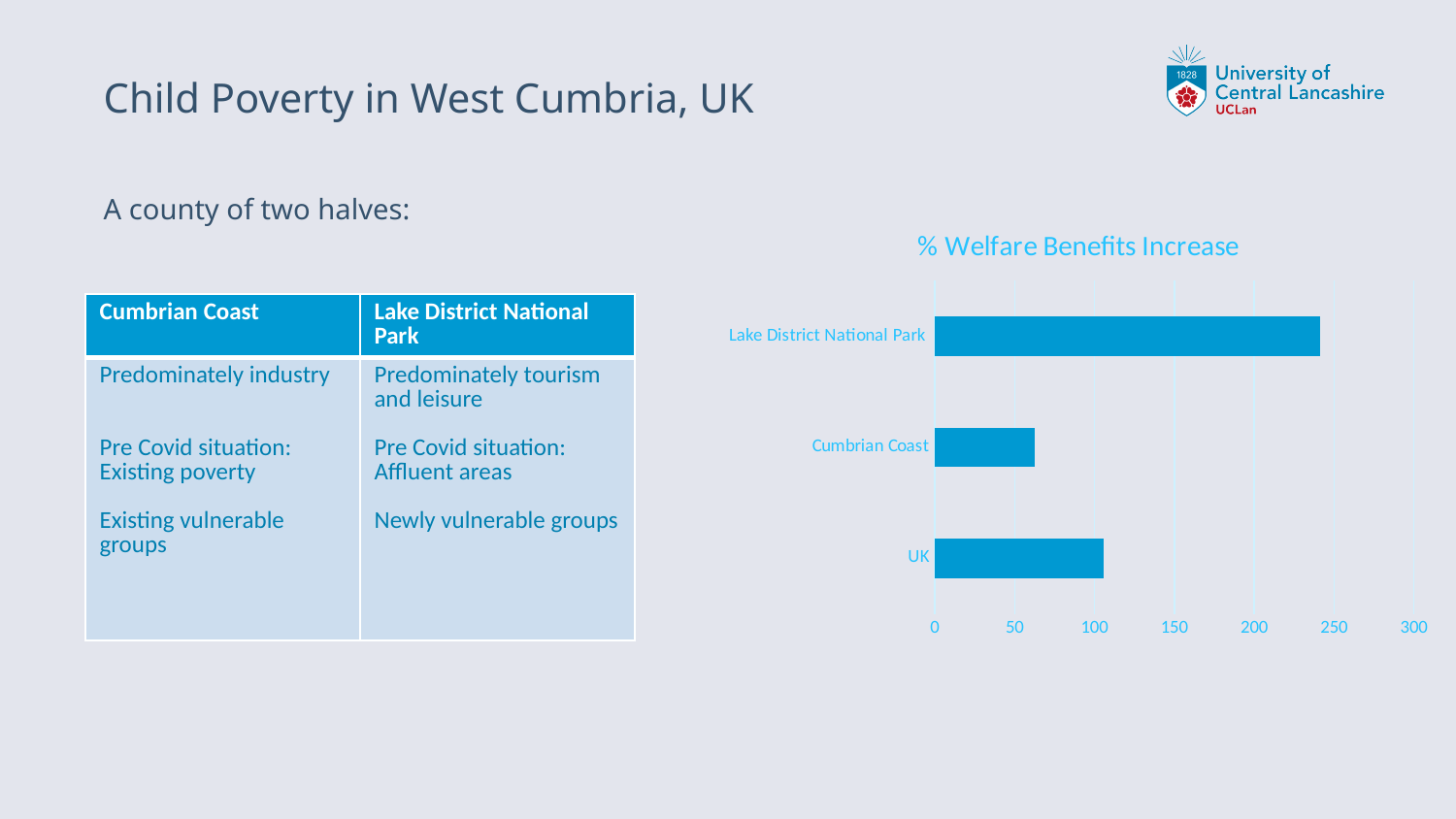
Which category has the lowest value in the % Welfare Benefits Increase chart? Cumbrian Coast Is the value for UK greater or less than 50? greater How many categories are plotted in the % Welfare Benefits Increase chart? 3 Is the value for Cumbrian Coast greater or less than 100? less Is the value for Lake District National Park greater or less than 200? greater Which category has the highest value in the % Welfare Benefits Increase chart? Lake District National Park What is the title of the chart on the slide? % Welfare Benefits Increase What is the highest value shown on the horizontal axis of the chart? 300 Which has the larger value, UK or Cumbrian Coast? UK What type of chart is shown on the slide? bar chart